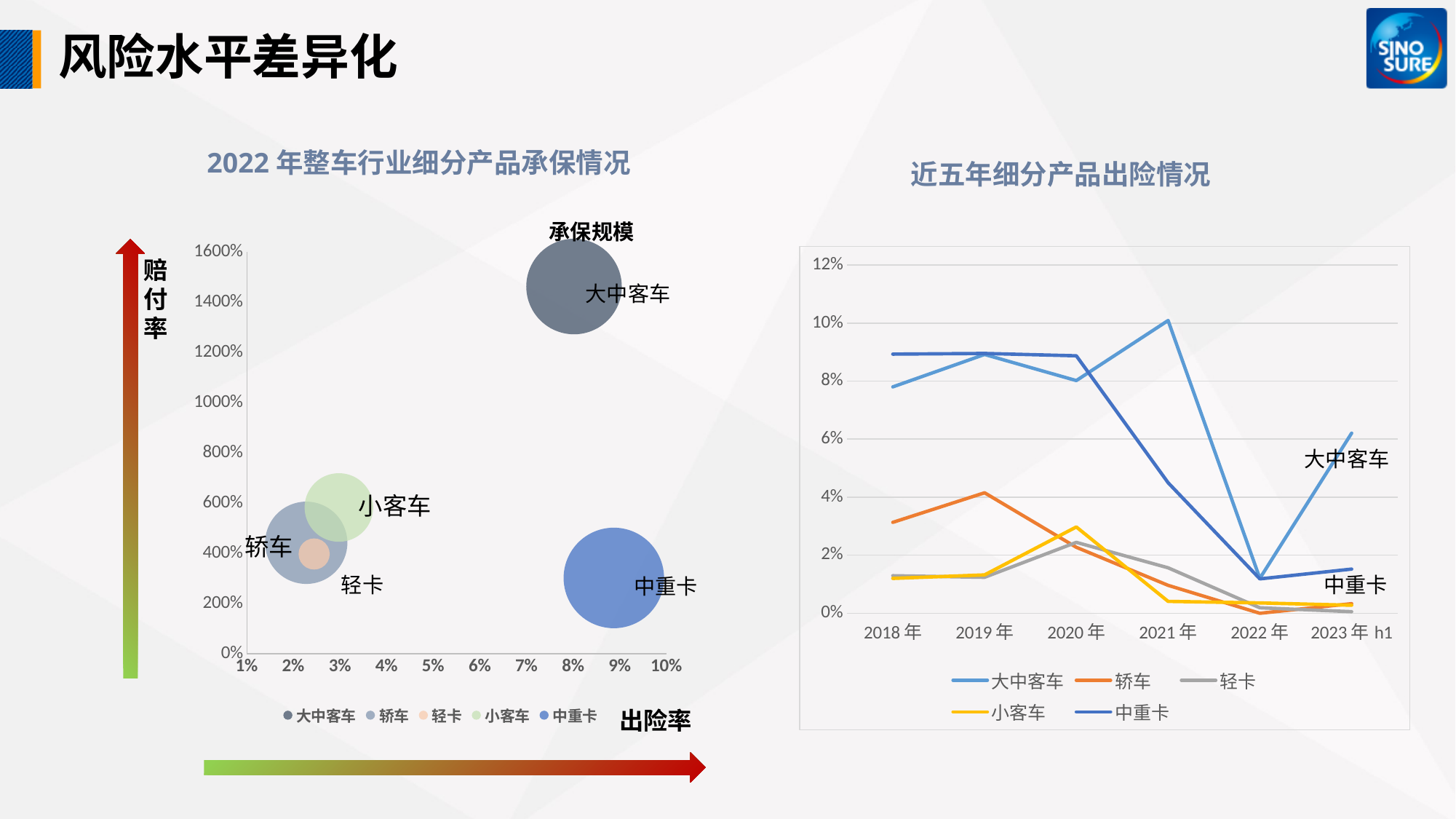
In the left chart (2022 年整车行业细分产品承保情况), which product has the highest 赔付率? 大中客车 In the right chart (近五年细分产品出险情况), does the 中重卡 line rise or fall from 2020 年 to 2022 年? fall In the left chart (2022 年整车行业细分产品承保情况), is the 赔付率 for 大中客车 greater or less than 1200%? greater In the left chart (2022 年整车行业细分产品承保情况), is the 出险率 for 中重卡 greater or less than 8%? greater In the right chart (近五年细分产品出险情况), is the value for 大中客车 in 2021 年 greater or less than 8%? greater In the right chart (近五年细分产品出险情况), which series is higher in 2018 年, 中重卡 or 大中客车? 中重卡 What kind of chart is the left chart titled 2022 年整车行业细分产品承保情况? bubble chart In the right chart (近五年细分产品出险情况), how many series does the legend list? 5 In the right chart (近五年细分产品出险情况), how many time points are shown on the x axis? 6 In the left chart (2022 年整车行业细分产品承保情况), which product has the highest 出险率? 中重卡 In the left chart (2022 年整车行业细分产品承保情况), how many product categories (bubbles) are plotted? 5 What kind of chart is the right chart titled 近五年细分产品出险情况? line chart